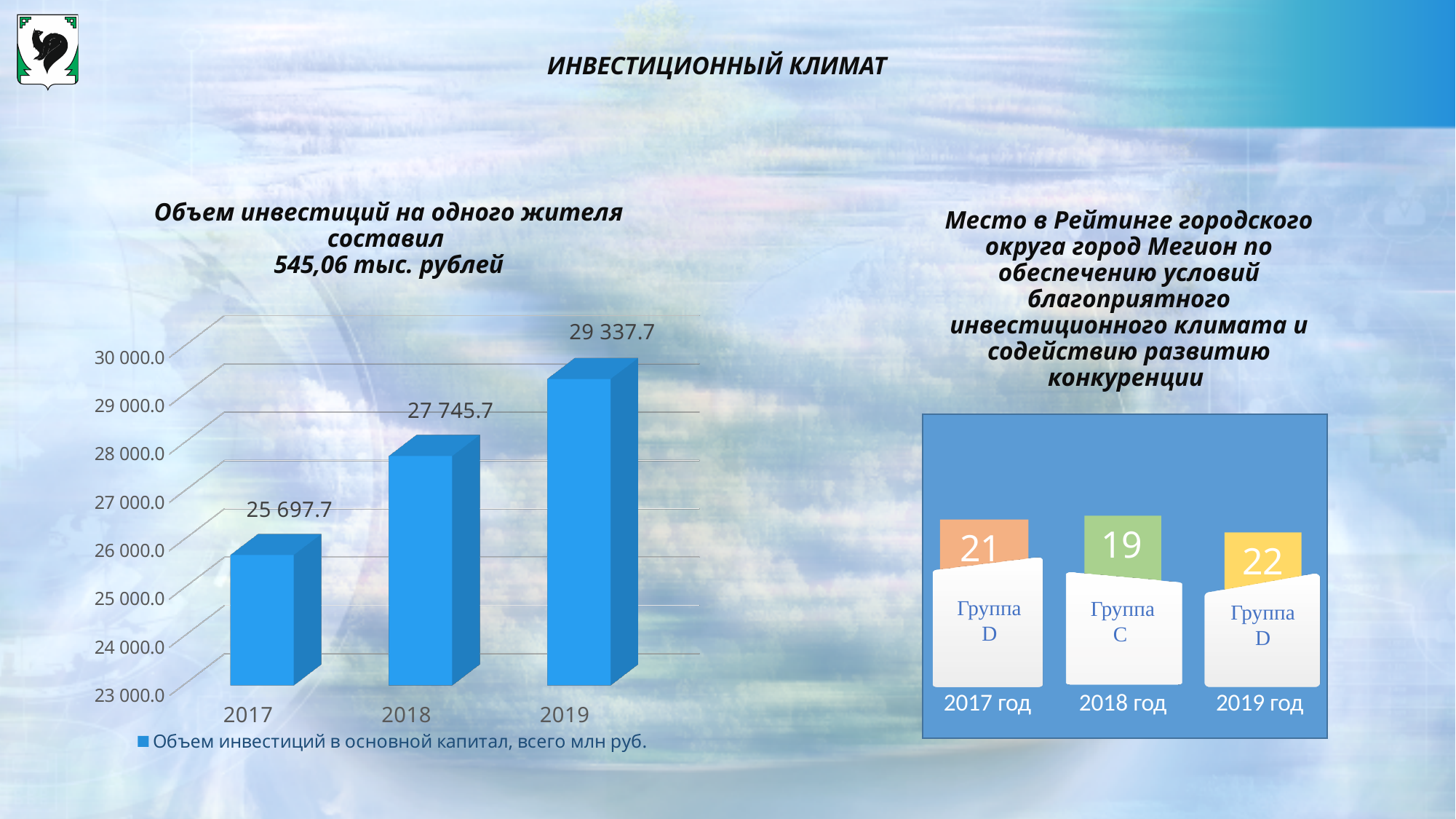
What is the value for 2018 in the bar chart? 27 745.7 What kind of chart is shown on the left of the slide? bar chart Which year has the lowest value in the bar chart? 2017 Do the values in the bar chart rise or fall from 2017 to 2019? rise What is the difference between the 2018 and 2017 values in the bar chart? 2 048.0 How many years are shown in the bar chart? 3 What is the value for 2017 in the bar chart? 25 697.7 What is the difference between the 2019 and 2018 values in the bar chart? 1 592.0 What is the value for 2019 in the bar chart? 29 337.7 Is the value for 2018 in the bar chart greater or less than 28 000.0? less Which year has the highest value in the bar chart? 2019 Which is larger in the bar chart, the value for 2017 or the value for 2019? 2019